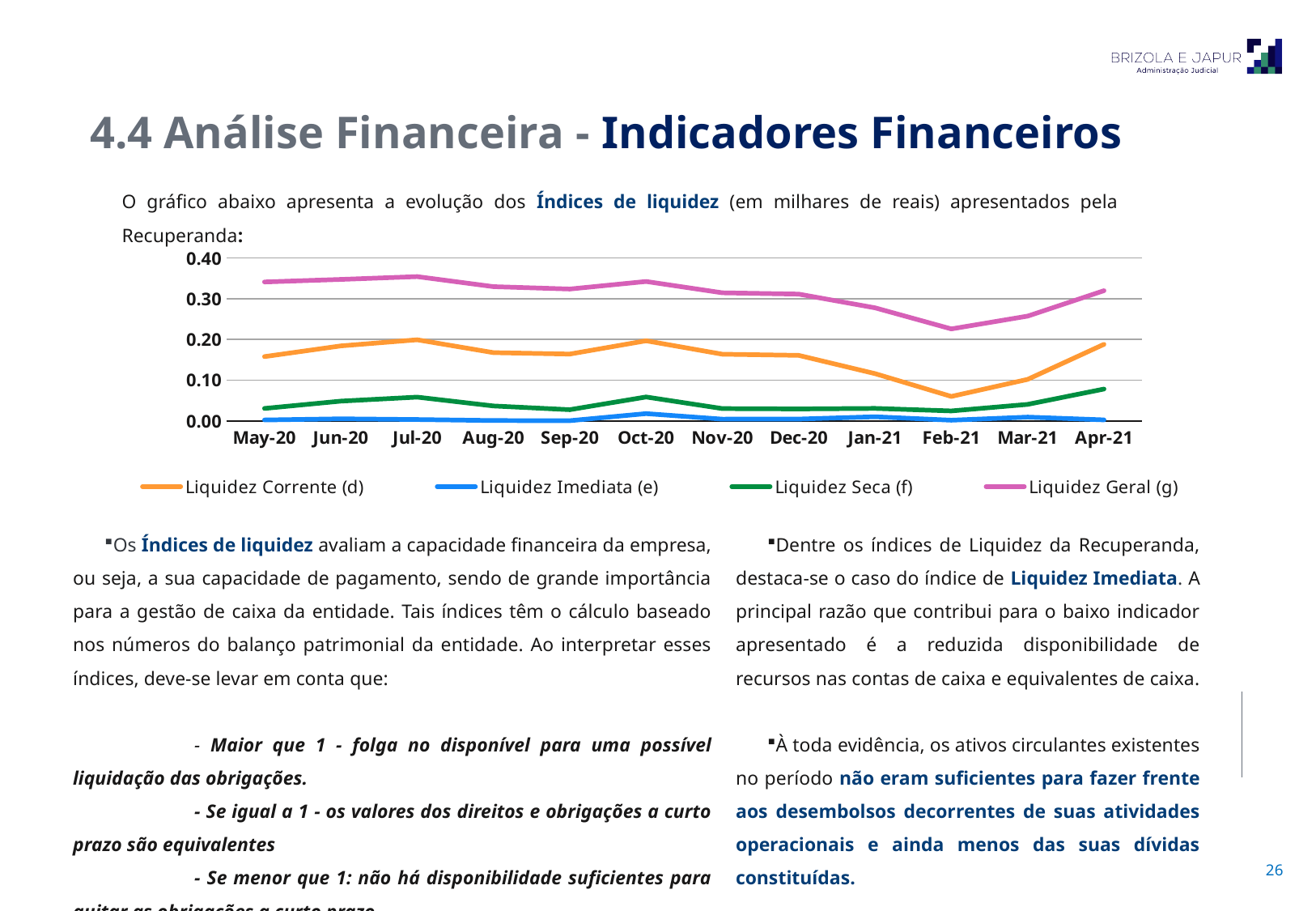
Does Liquidez Geral (g) rise or fall from Feb-21 to Apr-21? Rise In which month does Liquidez Corrente (d) reach its lowest value? Feb-21 Which series has the highest values across the whole period? Liquidez Geral (g) How many months are plotted along the x axis? 12 Is the value of Liquidez Seca (f) in Apr-21 greater or less than 0.10? less Is the value of Liquidez Corrente (d) in Jul-20 greater or less than 0.10? greater What kind of chart is shown on the slide? Line chart How many series does the legend list? 4 Is the value of Liquidez Geral (g) in Feb-21 greater or less than 0.30? less Which series has the lowest values across the whole period? Liquidez Imediata (e) In which month does Liquidez Geral (g) reach its lowest value? Feb-21 Which is larger in Oct-20, Liquidez Seca (f) or Liquidez Imediata (e)? Liquidez Seca (f)